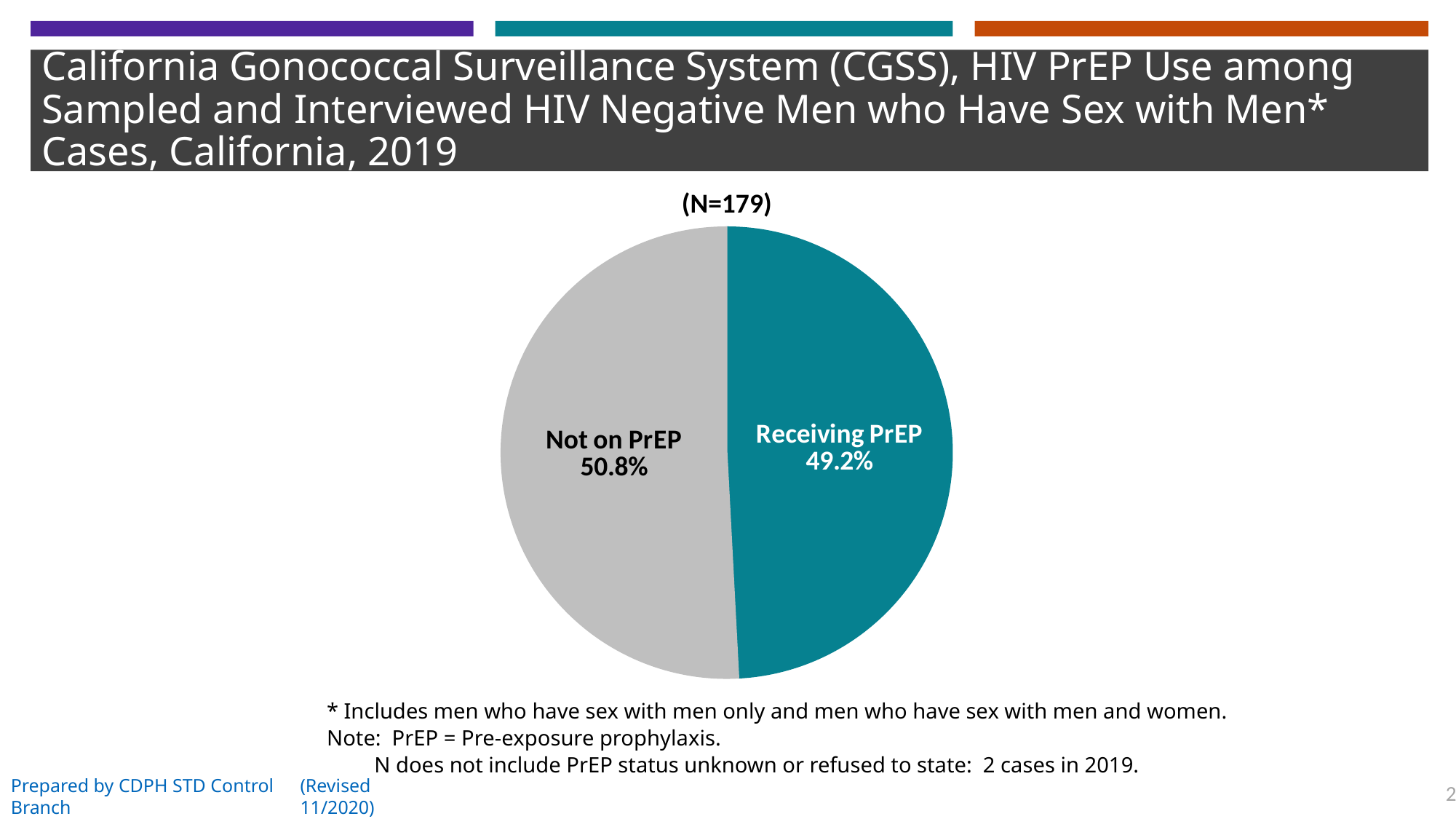
Which slice of the pie is larger, Not on PrEP or Receiving PrEP? Not on PrEP Is the share of cases receiving PrEP greater or less than 50%? less Which category has the smallest share of the pie? Receiving PrEP Which category has the largest share of the pie? Not on PrEP What colour is the Receiving PrEP slice? Teal What is the total number of cases (N) shown above the pie chart? 179 What is the difference in percentage points between the Not on PrEP and Receiving PrEP slices? 1.6 What percentage of cases were receiving PrEP? 49.2% What kind of chart is shown on the slide? Pie chart How many slices does the pie chart have? 2 What percentage of cases were not on PrEP? 50.8%